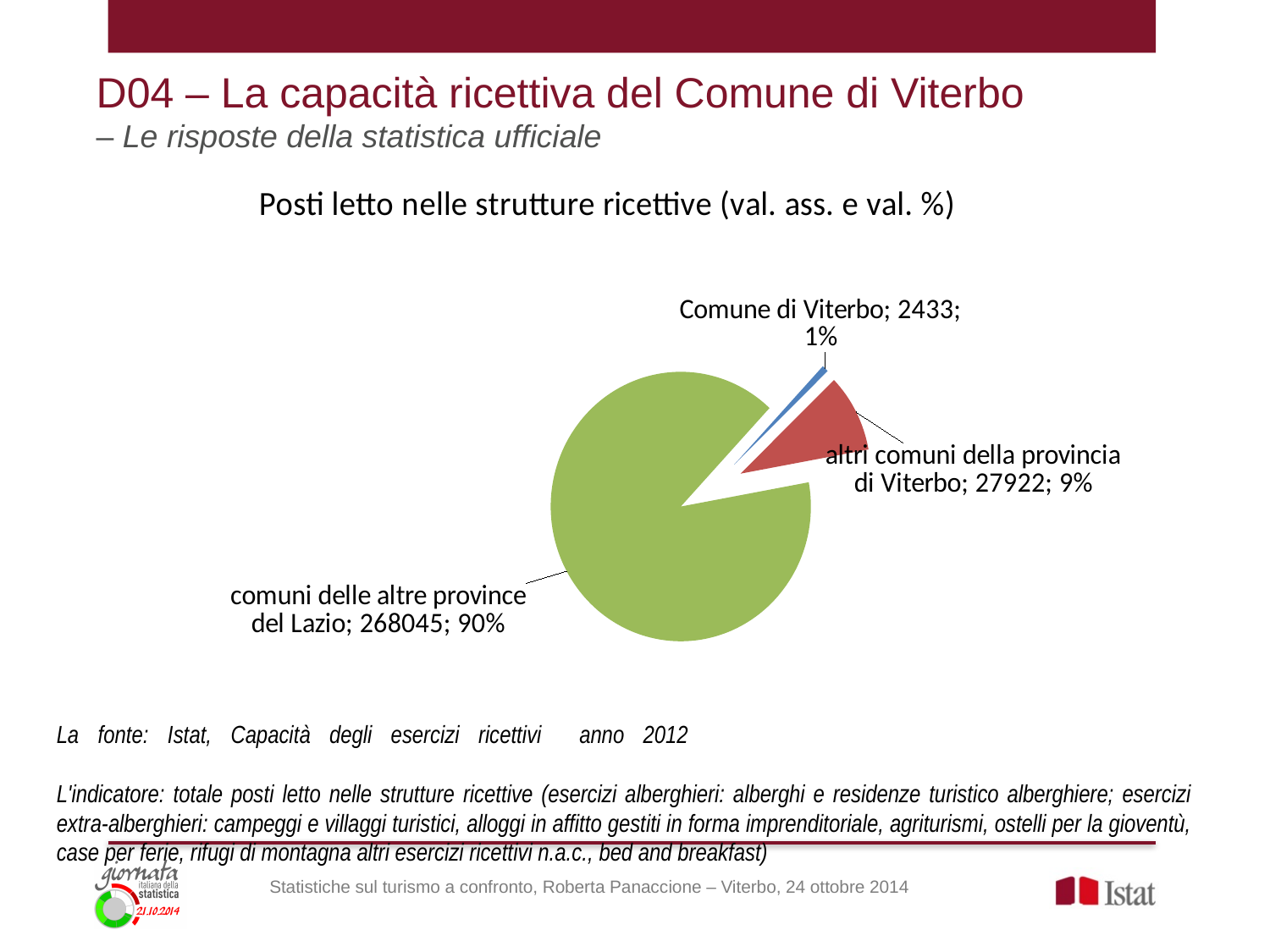
What is the title of the chart? Posti letto nelle strutture ricettive (val. ass. e val. %) What is the value for Comune di Viterbo? 2433 What is the value for comuni delle altre province del Lazio? 268045 What share of the pie does altri comuni della provincia di Viterbo represent? 9% What kind of chart is shown on the slide? pie chart What share of the pie does Comune di Viterbo represent? 1% Which category has the largest slice? comuni delle altre province del Lazio What is the value for altri comuni della provincia di Viterbo? 27922 What is the difference between the values for altri comuni della provincia di Viterbo and Comune di Viterbo? 25489 What share of the pie does comuni delle altre province del Lazio represent? 90% How many slices does the pie chart have? 3 Which category has the smallest slice? Comune di Viterbo